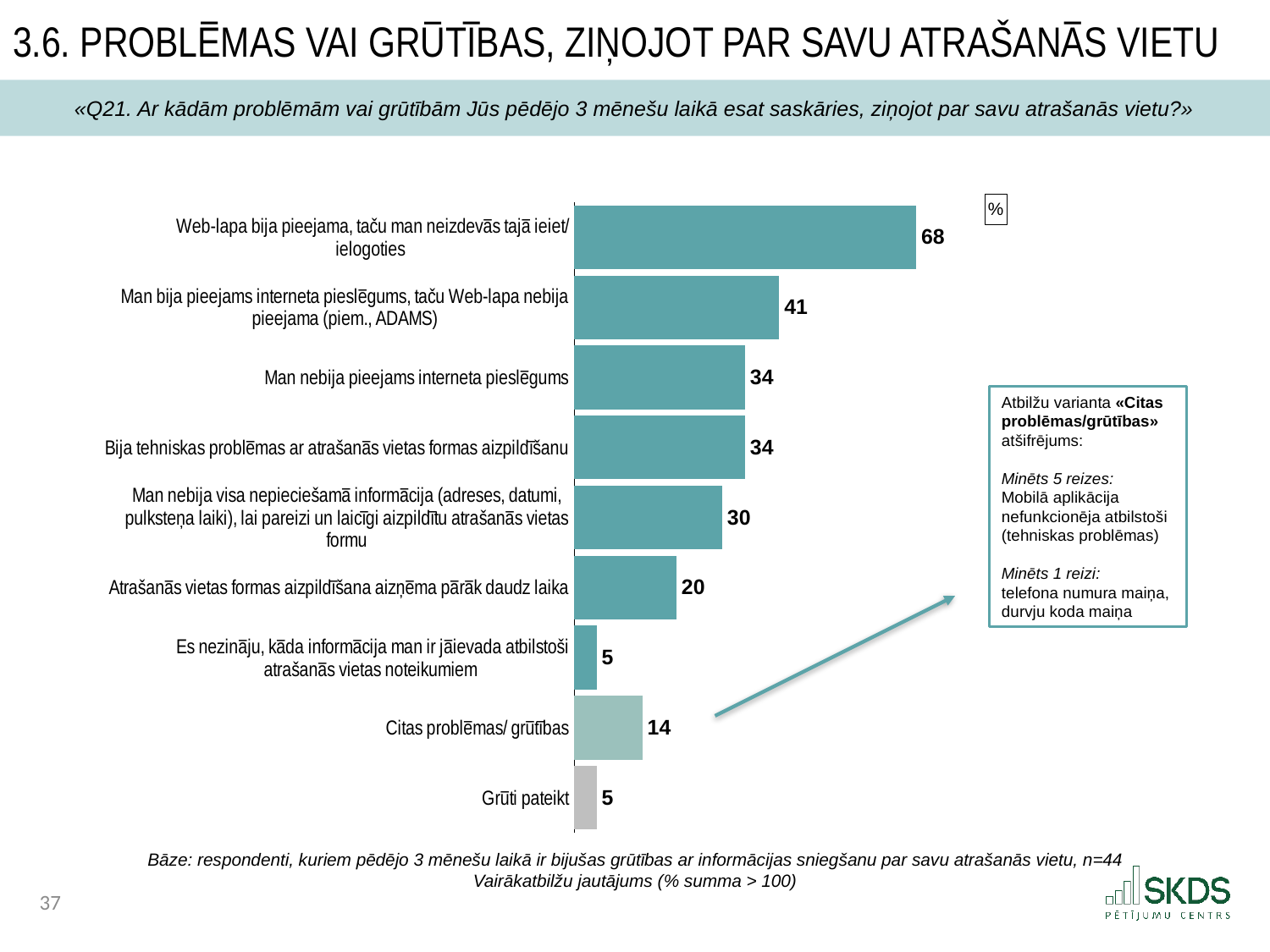
What is the value for "Web-lapa bija pieejama, taču man neizdevās tajā ieiet/ ielogoties"? 68 What is the difference between the values for "Web-lapa bija pieejama, taču man neizdevās tajā ieiet/ ielogoties" and "Man bija pieejams interneta pieslēgums, taču Web-lapa nebija pieejama (piem., ADAMS)"? 27 Which category has the highest value? Web-lapa bija pieejama, taču man neizdevās tajā ieiet/ ielogoties Which is larger: the value for "Citas problēmas/ grūtības" or the value for "Grūti pateikt"? Citas problēmas/ grūtības What is the difference between the values for "Man nebija visa nepieciešamā informācija (adreses, datumi, pulksteņa laiki), lai pareizi un laicīgi aizpildītu atrašanās vietas formu" and "Atrašanās vietas formas aizpildīšana aizņēma pārāk daudz laika"? 10 What is the value for "Man bija pieejams interneta pieslēgums, taču Web-lapa nebija pieejama (piem., ADAMS)"? 41 How many categories are shown in the chart? 9 What is the value for "Citas problēmas/ grūtības"? 14 What is the value for "Atrašanās vietas formas aizpildīšana aizņēma pārāk daudz laika"? 20 What is the value for "Bija tehniskas problēmas ar atrašanās vietas formas aizpildīšanu"? 34 What kind of chart is shown on the slide? Bar chart Which is larger: the value for "Man nebija pieejams interneta pieslēgums" or the value for "Atrašanās vietas formas aizpildīšana aizņēma pārāk daudz laika"? Man nebija pieejams interneta pieslēgums